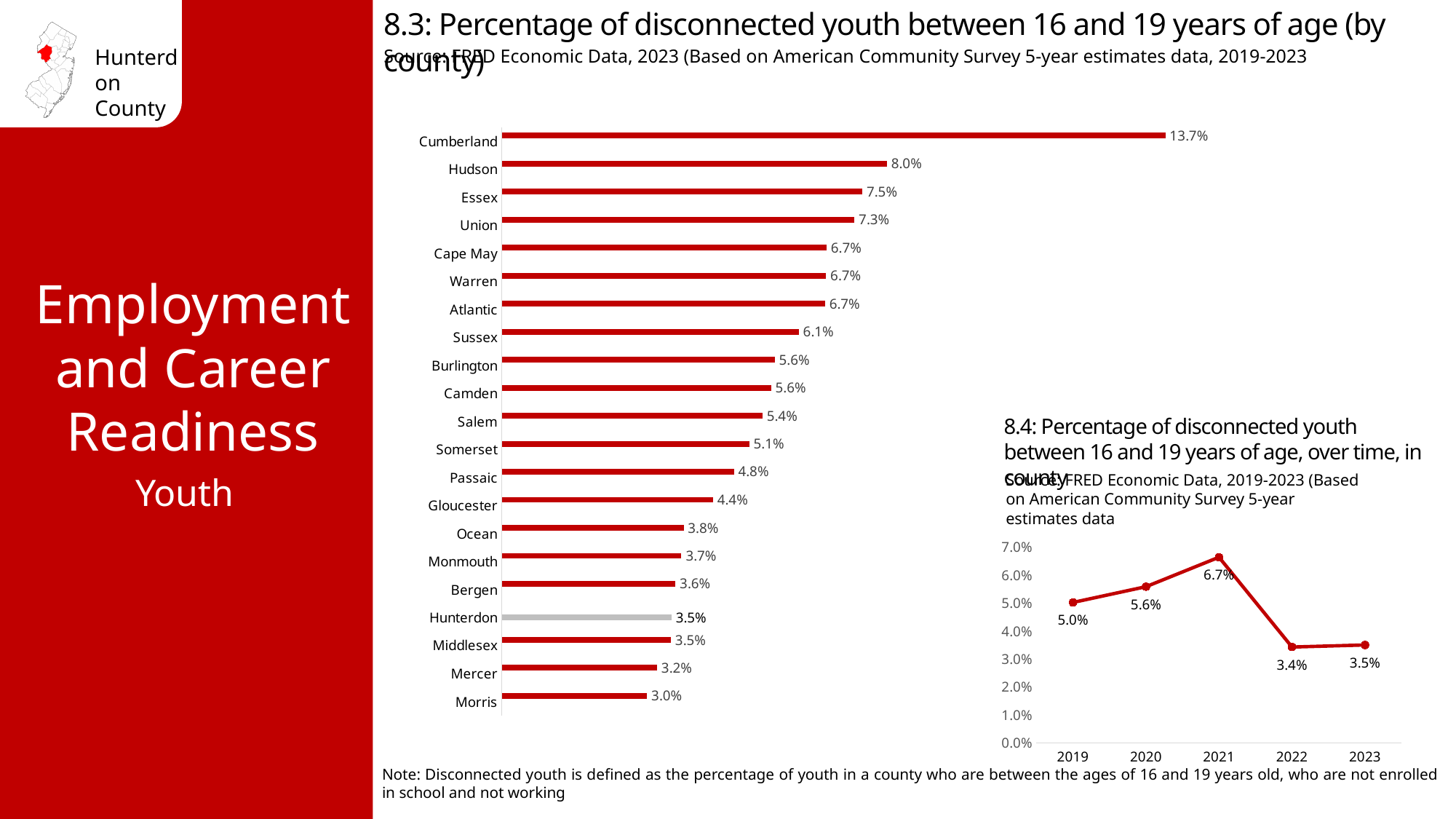
In the bar chart 8.3, what is the difference between the values for Hudson and Essex? 0.5% How many counties are shown in the bar chart 8.3? 21 In the line chart 8.4, which year has the lowest value? 2022 In the bar chart 8.3, what is the value for Hunterdon? 3.5% In the bar chart 8.3 (percentage of disconnected youth by county), what is the value for Cumberland? 13.7% In the bar chart 8.3, which county's bar is shown in grey rather than red? Hunterdon In the line chart 8.4, what is the difference between the values for 2021 and 2022? 3.3% What type of chart is chart 8.3 on the left? Bar chart In the bar chart 8.3, which county has the highest percentage of disconnected youth? Cumberland In the line chart 8.4 (disconnected youth over time), what is the value for 2021? 6.7% In the bar chart 8.3, which county has the lowest percentage of disconnected youth? Morris In the bar chart 8.3, which county has a larger value, Sussex or Salem? Sussex